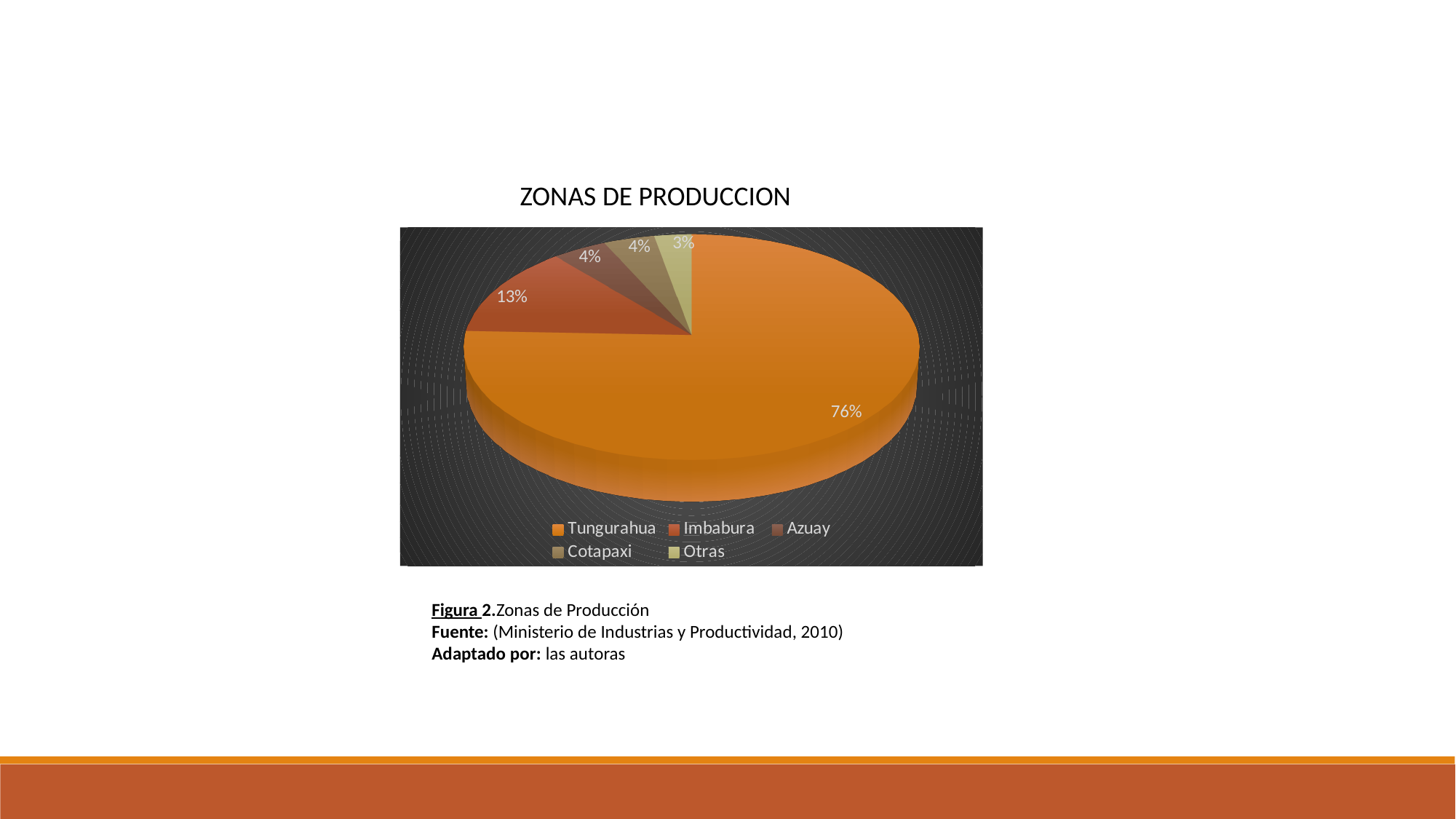
What is the value shown for Otras? 3% What share of the pie does Tungurahua represent? 76% What is the value shown for Azuay? 4% How many categories does the legend list? 5 What is the value shown for Cotapaxi? 4% Which is larger, the slice for Imbabura or the slice for Azuay? Imbabura What type of chart is shown on the slide? pie chart What is the value shown for Imbabura? 13% What is the title of the chart? ZONAS DE PRODUCCION Which category has the smallest slice of the pie? Otras What is the difference in percentage points between Tungurahua and Imbabura? 63 Which category has the largest slice of the pie? Tungurahua